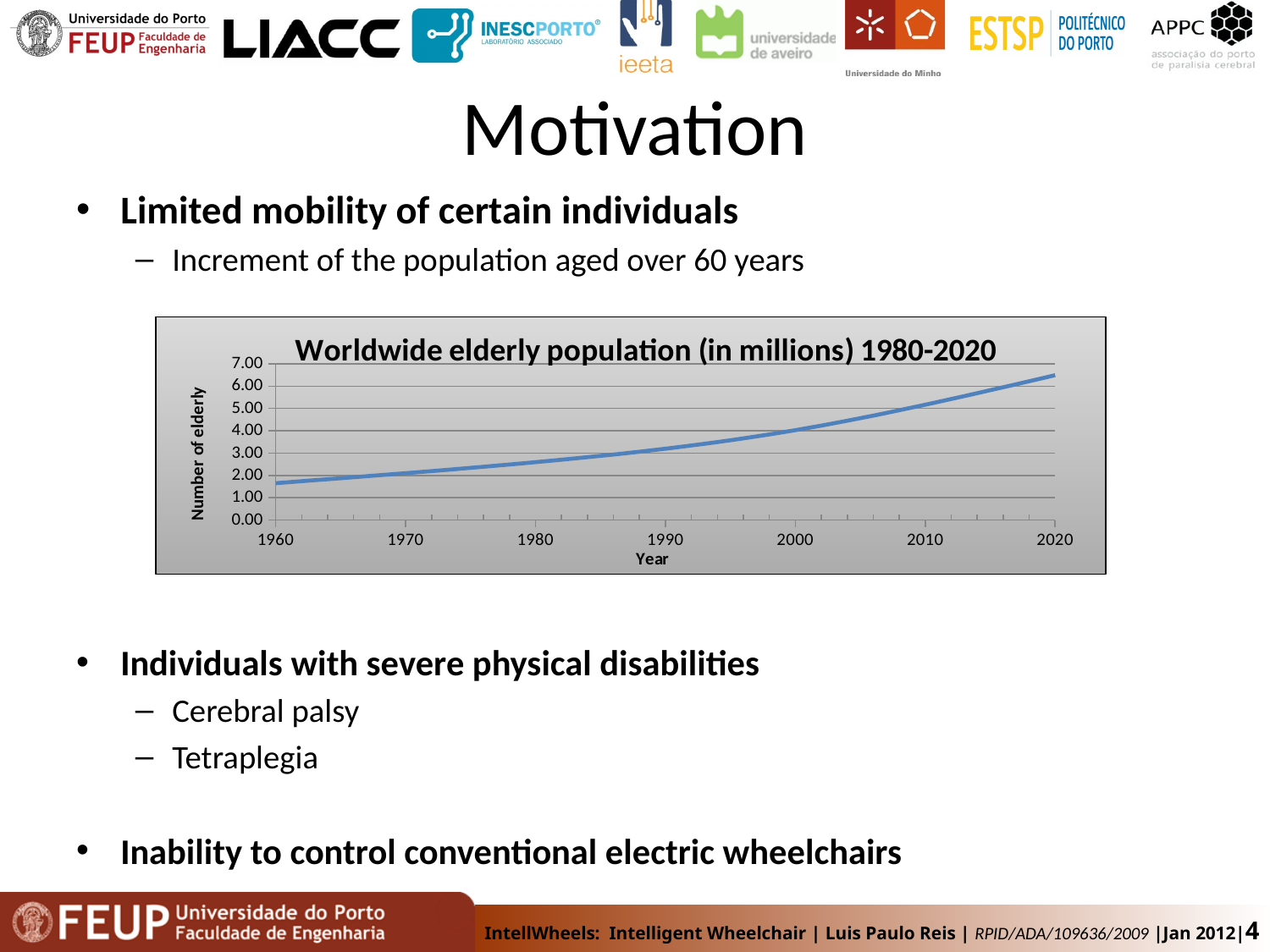
Is the value for 1980 greater or less than 3.00? less Do the values in the chart rise or fall as the year increases from 1960 to 2020? rise How many year labels are shown on the x axis of the chart? 7 In which year shown on the x axis is the number of elderly lowest? 1960 What is the title of the chart? Worldwide elderly population (in millions) 1980-2020 What is the label of the vertical axis of the chart? Number of elderly Is the value for 2020 greater or less than 6.00? greater Is the value for 2010 greater or less than 4.00? greater In which year shown on the x axis is the number of elderly highest? 2020 What kind of chart is shown on the slide? line chart Which is larger, the value for 1970 or the value for 2000? 2000